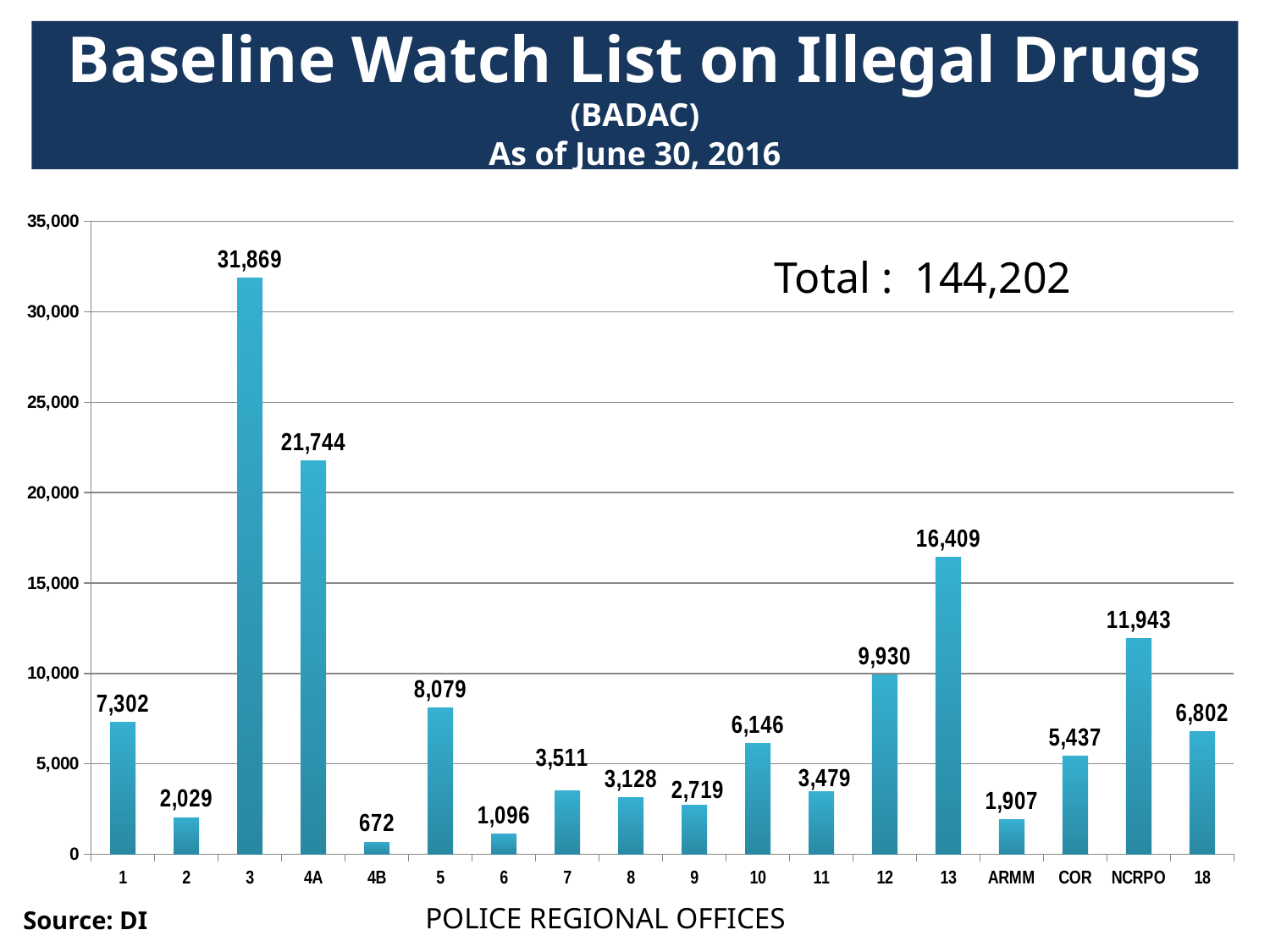
What is the value for NCRPO? 11,943 How many police regional offices are shown on the x axis? 18 Is the value for region 12 greater or less than 10,000? less Which police regional office has the highest value? 3 What total is printed on the chart? 144,202 What is the x-axis label of the chart? POLICE REGIONAL OFFICES Which is larger, the value for region 13 or the value for NCRPO? 13 Which police regional office has the lowest value? 4B What is the difference between the values for region 3 and region 4A? 10,125 What kind of chart is shown on the slide? bar chart What is the value for ARMM? 1,907 What is the value for region 3? 31,869